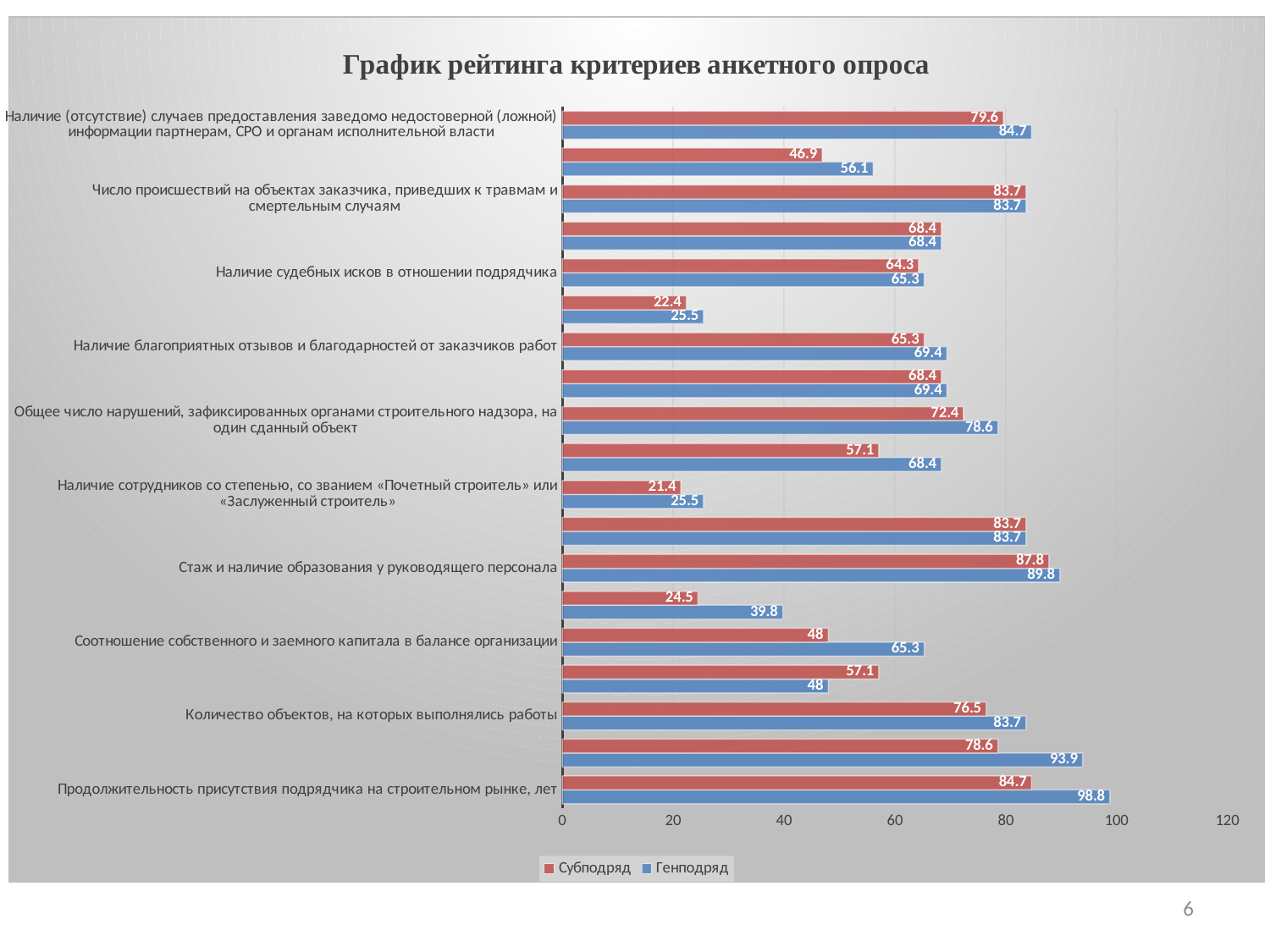
What is the Субподряд value for «Стаж и наличие образования у руководящего персонала»? 87.8 Which category has the lowest Субподряд value? Наличие сотрудников со степенью, со званием «Почетный строитель» или «Заслуженный строитель» How many series does the legend list? 2 For «Общее число нарушений, зафиксированных органами строительного надзора, на один сданный объект», which series has the larger value, Субподряд or Генподряд? Генподряд What is the Генподряд value for «Количество объектов, на которых выполнялись работы»? 83.7 Which category has the highest Генподряд value? Продолжительность присутствия подрядчика на строительном рынке, лет What type of chart is shown on the slide? bar chart What is the Генподряд value for «Продолжительность присутствия подрядчика на строительном рынке, лет»? 98.8 What is the difference between the Генподряд and Субподряд values for «Продолжительность присутствия подрядчика на строительном рынке, лет»? 14.1 What is the Субподряд value for «Соотношение собственного и заемного капитала в балансе организации»? 48 What is the difference between the Генподряд and Субподряд values for «Соотношение собственного и заемного капитала в балансе организации»? 17.3 What is the title of the chart? График рейтинга критериев анкетного опроса